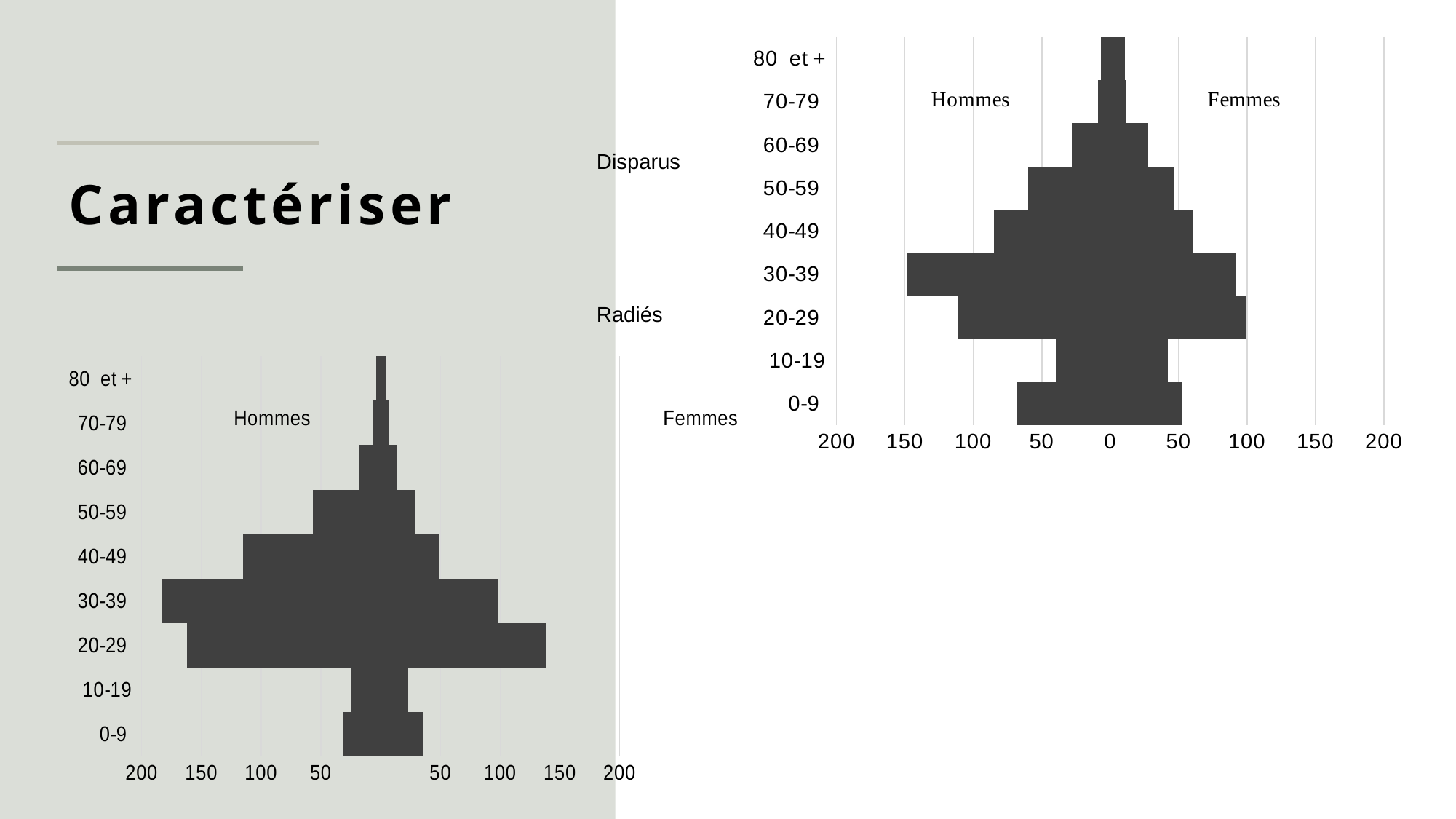
In the 'Disparus' chart, is the Hommes value for 30-39 greater or less than 100? greater In the 'Radiés' chart, is the Hommes value for 30-39 greater or less than 150? greater In the 'Disparus' chart, which age group has the longest Hommes bar? 30-39 In the 'Radiés' chart, which is larger for the 40-49 age group, the Hommes value or the Femmes value? Hommes In the 'Radiés' chart, which age group has the longest Hommes bar? 30-39 In the 'Radiés' chart, is the Femmes value for 20-29 greater or less than 100? greater In the 'Disparus' chart, what are the two sides of the pyramid labelled? Hommes and Femmes What kind of chart is the 'Disparus' chart? bar chart In the 'Radiés' chart, which age group has the longest Femmes bar? 20-29 What kind of chart is the 'Radiés' chart? bar chart In the 'Disparus' chart, how many age groups are shown on the vertical axis? 9